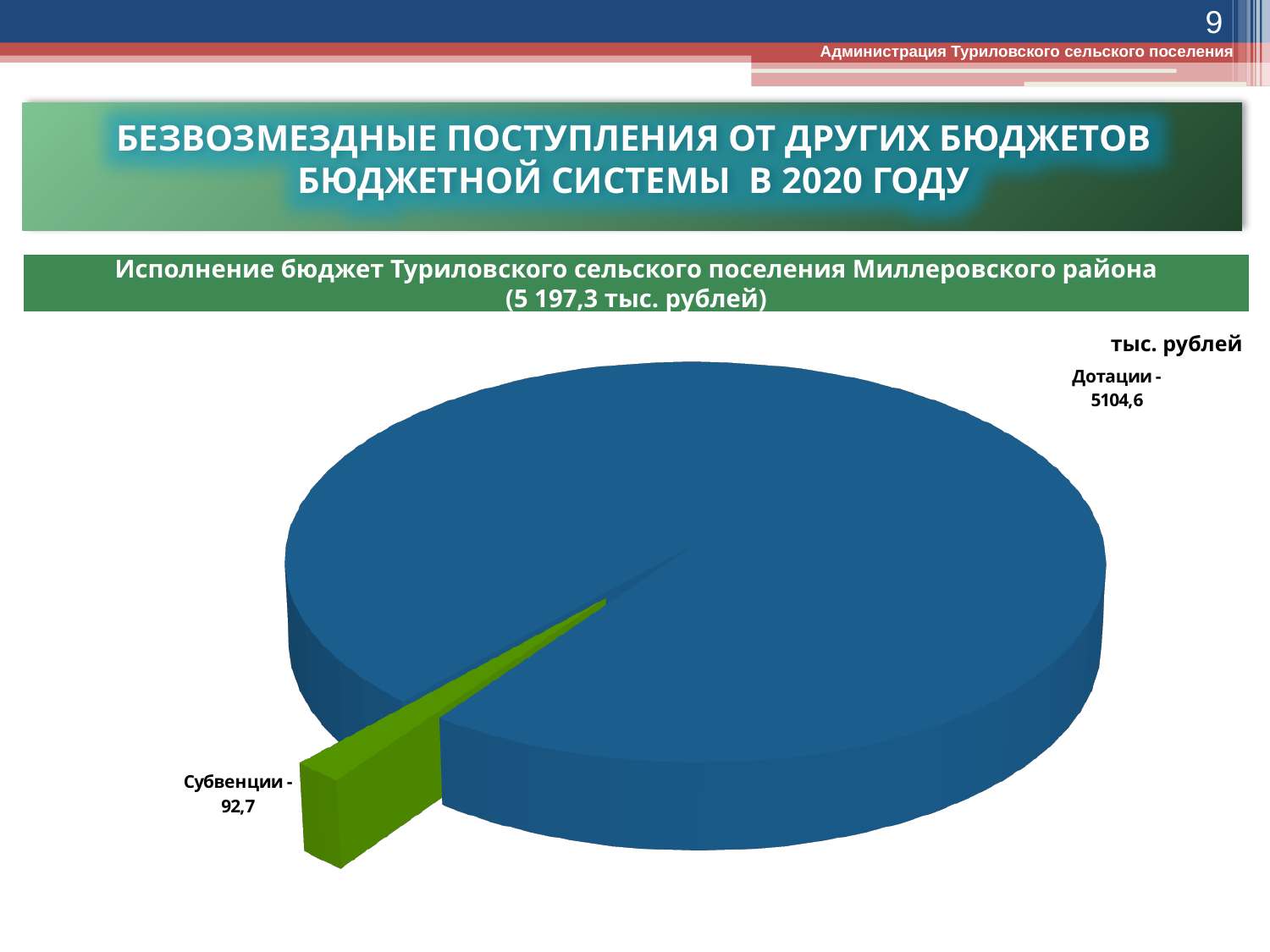
What is the difference between the values for Дотации and Субвенции? 5011,9 What unit is indicated for the values in the pie chart? тыс. рублей Which category has the largest slice in the pie chart? Дотации How many slices does the pie chart have? 2 Which is larger, Дотации or Субвенции? Дотации What is the value for Субвенции in the pie chart? 92,7 What is the value for Дотации in the pie chart? 5104,6 What colour is the Субвенции slice in the pie chart? Green Which category has the smallest slice in the pie chart? Субвенции What type of chart is shown on the slide? Pie chart What is the total of the two slices in the pie chart, as stated on the slide? 5 197,3 тыс. рублей